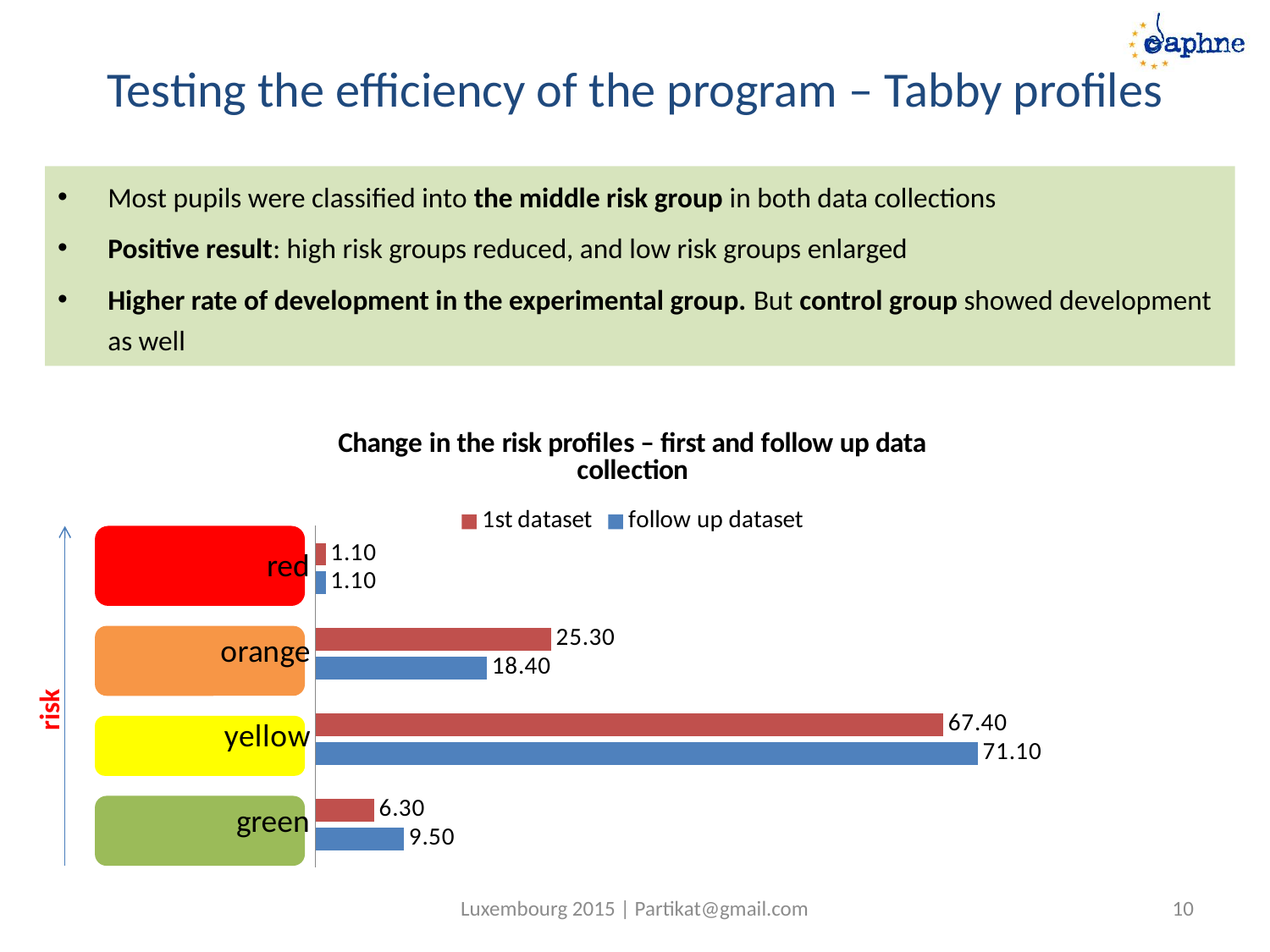
Which category has the lowest value in the 1st dataset? red What is the difference between the 1st dataset and follow up dataset values for orange? 6.90 Which category has the highest value in the follow up dataset? yellow What is the value for orange in the follow up dataset? 18.40 What is the difference between the follow up dataset and 1st dataset values for green? 3.20 What is the title of the chart? Change in the risk profiles – first and follow up data collection For yellow, which is larger: the 1st dataset value or the follow up dataset value? follow up dataset How many risk categories are shown on the chart? 4 How many series does the legend list? 2 What is the value for green in the follow up dataset? 9.50 What kind of chart is shown on the slide? bar chart What is the value for yellow in the 1st dataset? 67.40